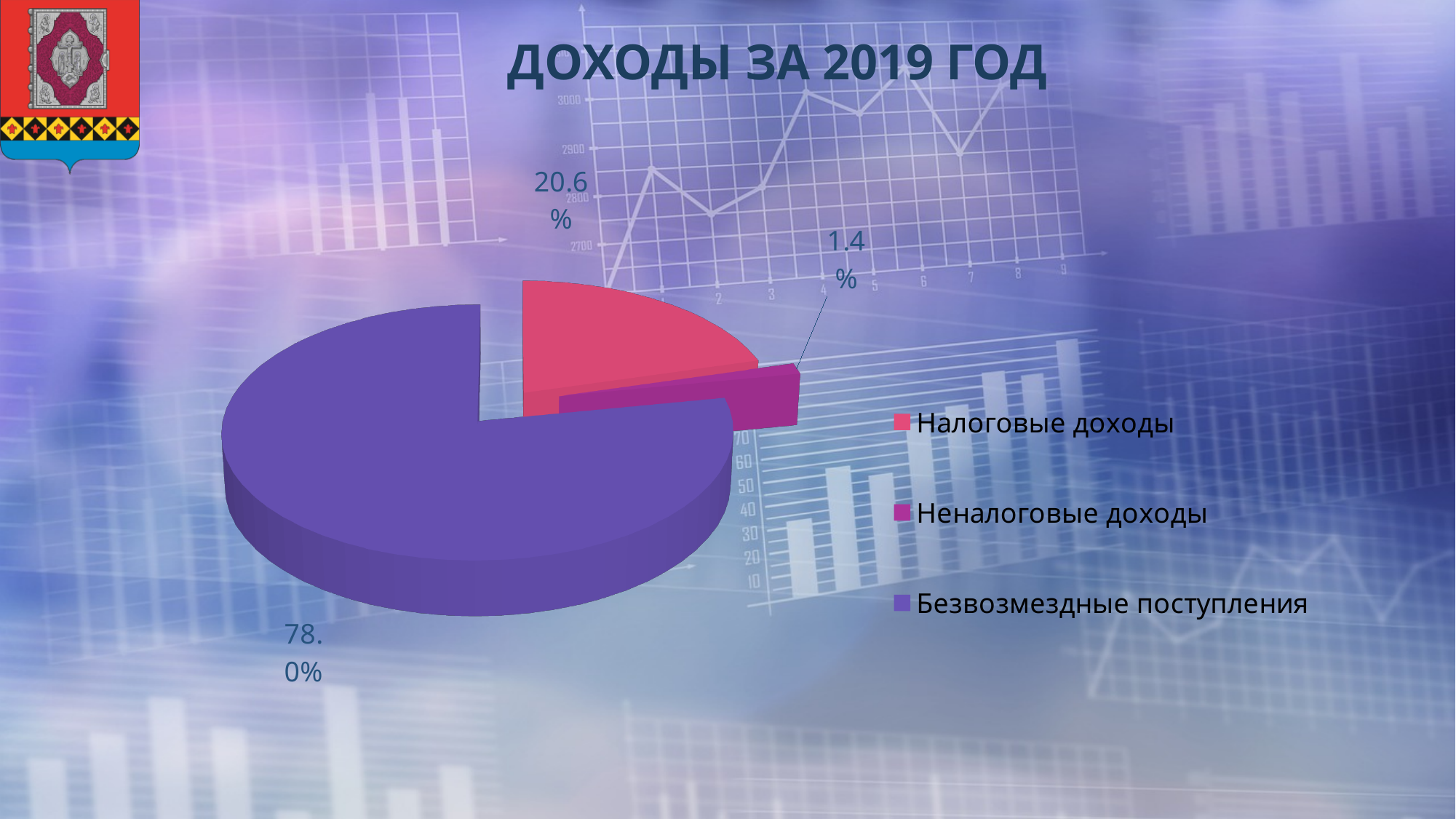
Which is larger, the share for Налоговые доходы or the share for Неналоговые доходы? Налоговые доходы What kind of chart is shown on the slide? Pie chart How many categories does the pie chart have? 3 What colour is the slice for Безвозмездные поступления? Purple What is the title of the chart? ДОХОДЫ ЗА 2019 ГОД What share of the pie is Налоговые доходы? 20.6% What is the difference in percentage points between Безвозмездные поступления and Налоговые доходы? 57.4 What share of the pie is Неналоговые доходы? 1.4% What share of the pie is Безвозмездные поступления? 78.0% Which category has the smallest share of the pie? Неналоговые доходы Which category has the largest share of the pie? Безвозмездные поступления How many entries does the legend list? 3